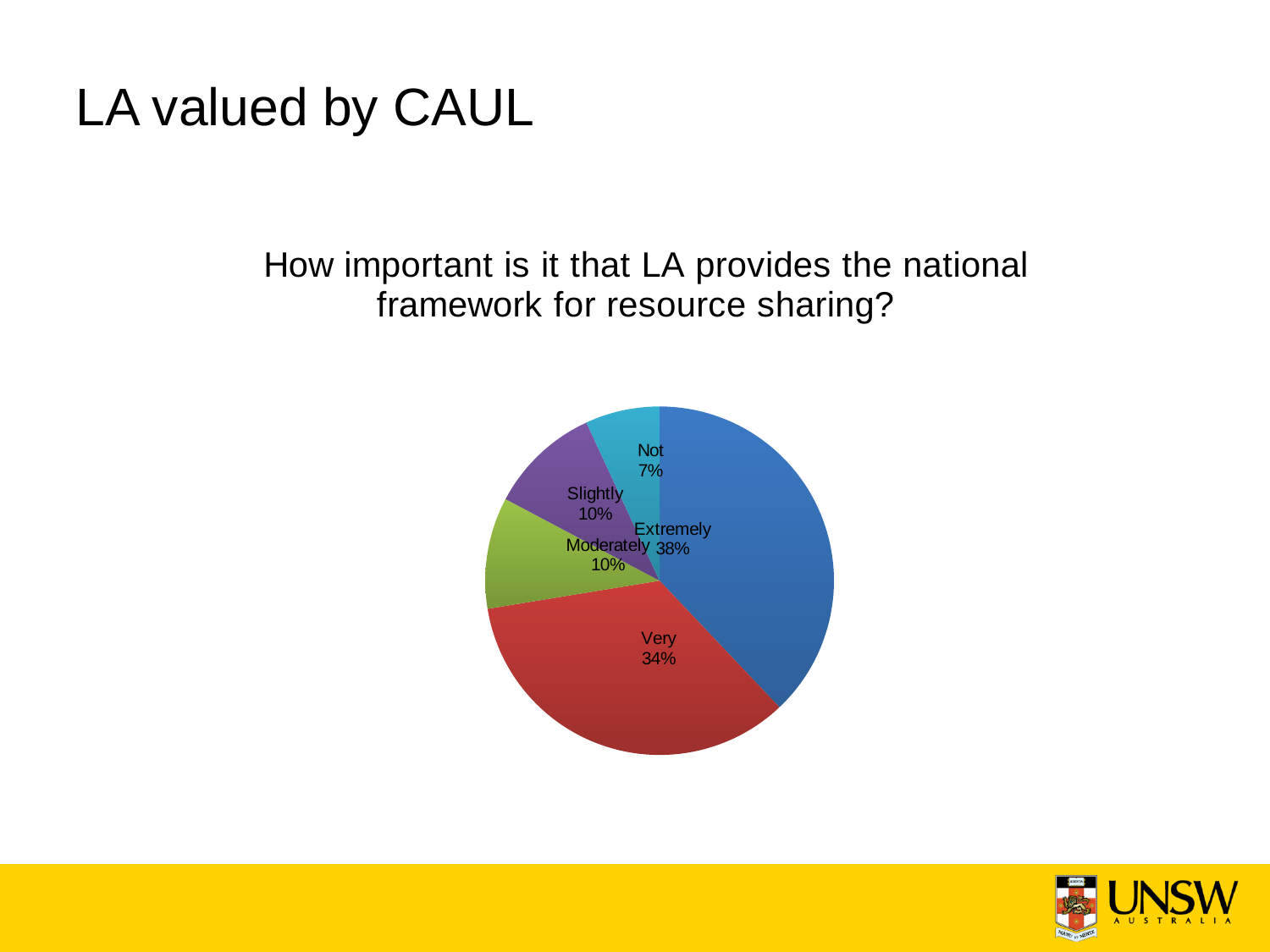
What kind of chart is shown on the slide? pie chart What is the combined share of the Extremely and Very slices? 72% What share of the pie is labelled Moderately? 10% What share of the pie is labelled Not? 7% Which slice of the pie is the smallest? Not What is the difference in percentage points between the Extremely and Very slices? 4% Which slice of the pie is the largest? Extremely What share of the pie is labelled Extremely? 38% What is the title of the chart? How important is it that LA provides the national framework for resource sharing? How many slices does the pie chart have? 5 Which is larger, the Slightly slice or the Not slice? Slightly